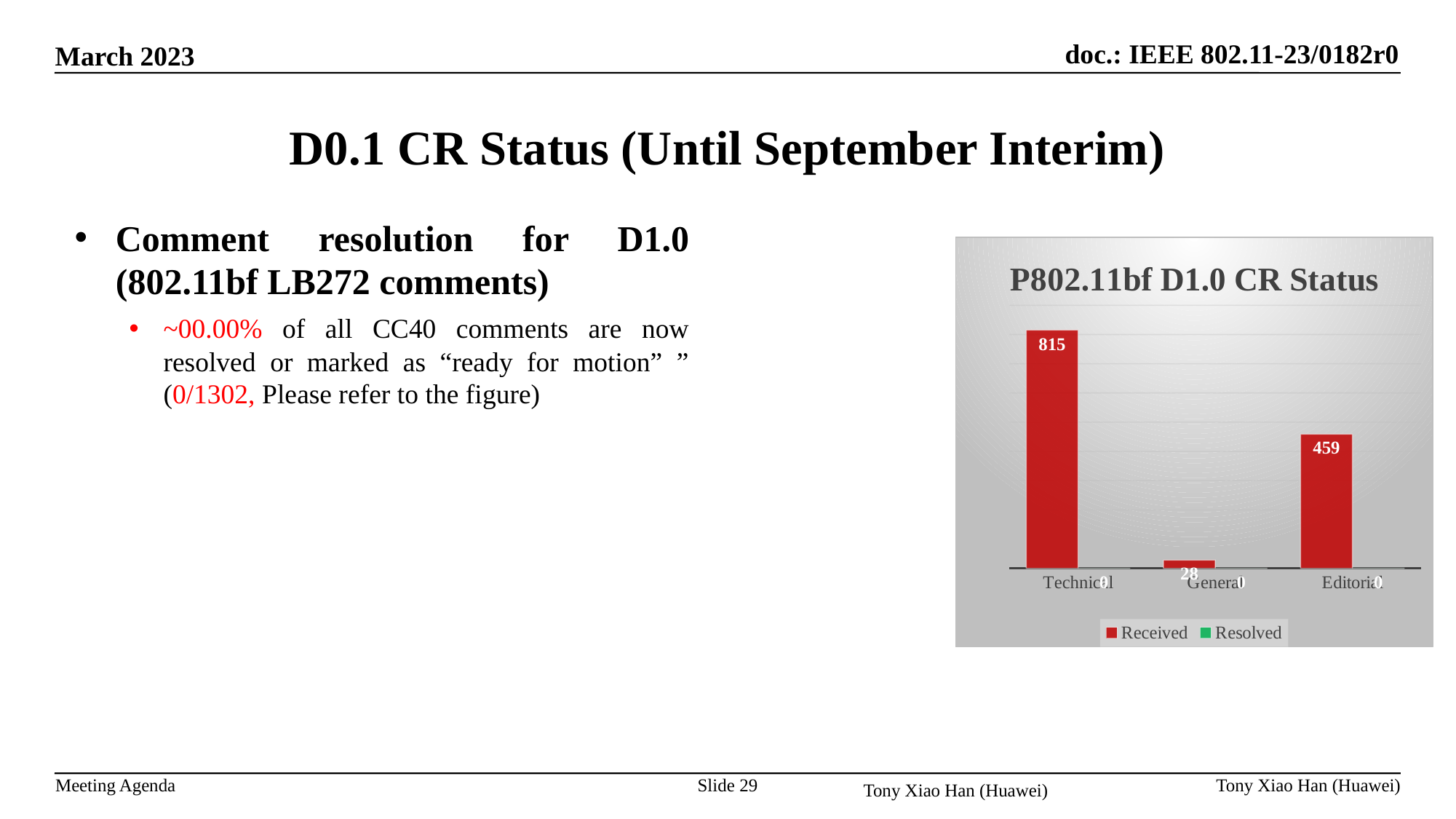
What type of chart is shown on the slide? bar chart Which is larger, the Received value for Editorial or for General? Editorial What is the title of the chart? P802.11bf D1.0 CR Status How many series does the chart legend list? 2 Which category has the highest Received value? Technical What is the Received value for General? 28 How many categories are shown on the x axis of the chart? 3 Which category has the lowest Received value? General What is the difference between the Received values for Technical and Editorial? 356 What is the Received value for Editorial? 459 What is the Resolved value for Technical? 0 What is the Received value for Technical? 815